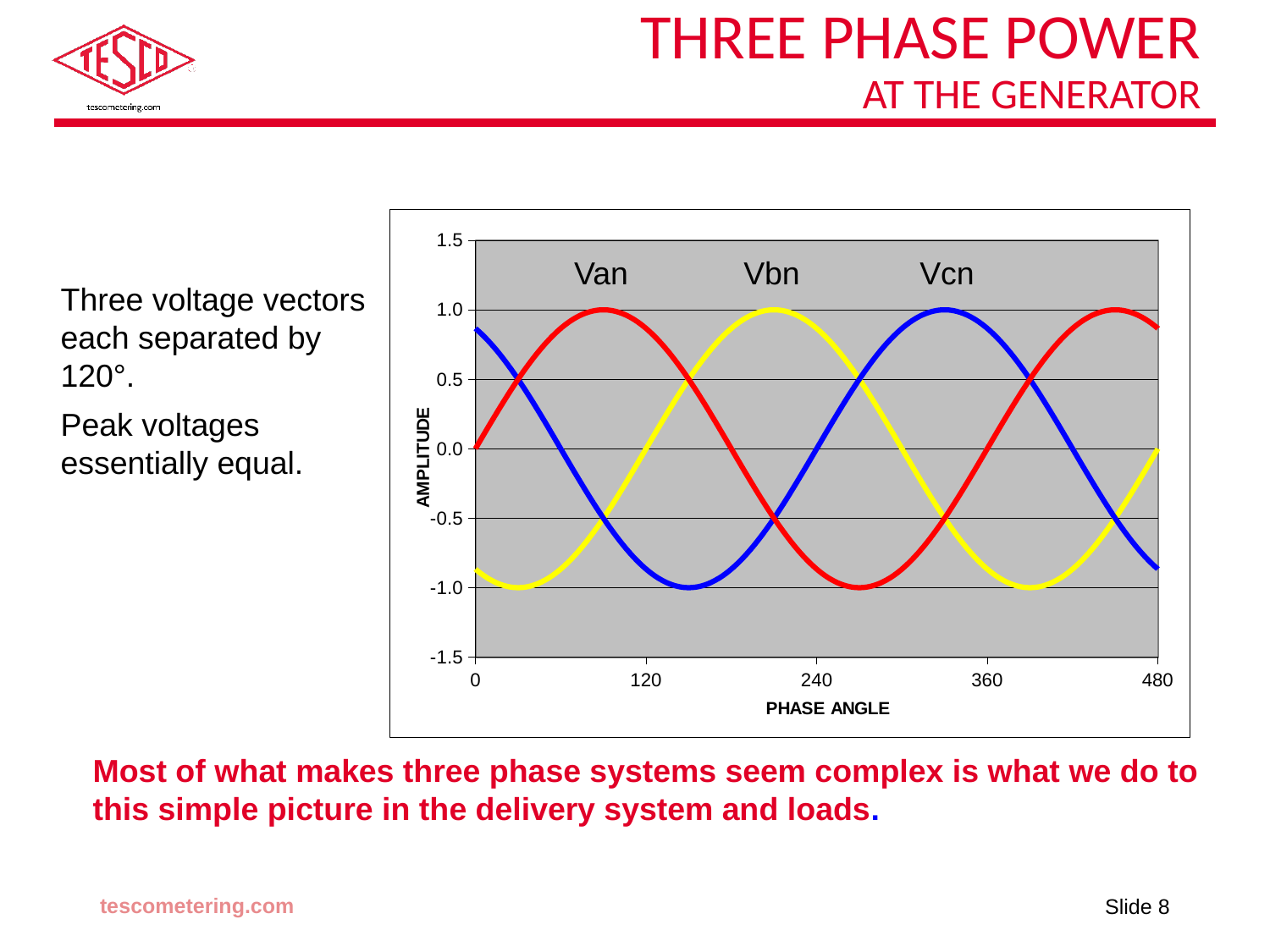
How many voltage series are plotted on the chart? 3 What is the amplitude of Van at a phase angle of 0? 0.0 Is the amplitude of Vbn at a phase angle of 0 greater or less than -0.5? less Between phase angles 120 and 240, does the Van line rise or fall? fall What is the label on the horizontal axis of the chart? PHASE ANGLE Which series has the highest amplitude at a phase angle of 0? Vcn Is the amplitude of Vcn at a phase angle of 0 greater or less than 0.5? greater What kind of chart is shown on the slide? line chart What is the peak amplitude reached by the Van line? 1.0 What colour is the Van line on the chart? red At a phase angle of 0, which is larger, the amplitude of Van or the amplitude of Vbn? Van What is the lowest amplitude reached by the Vbn line? -1.0